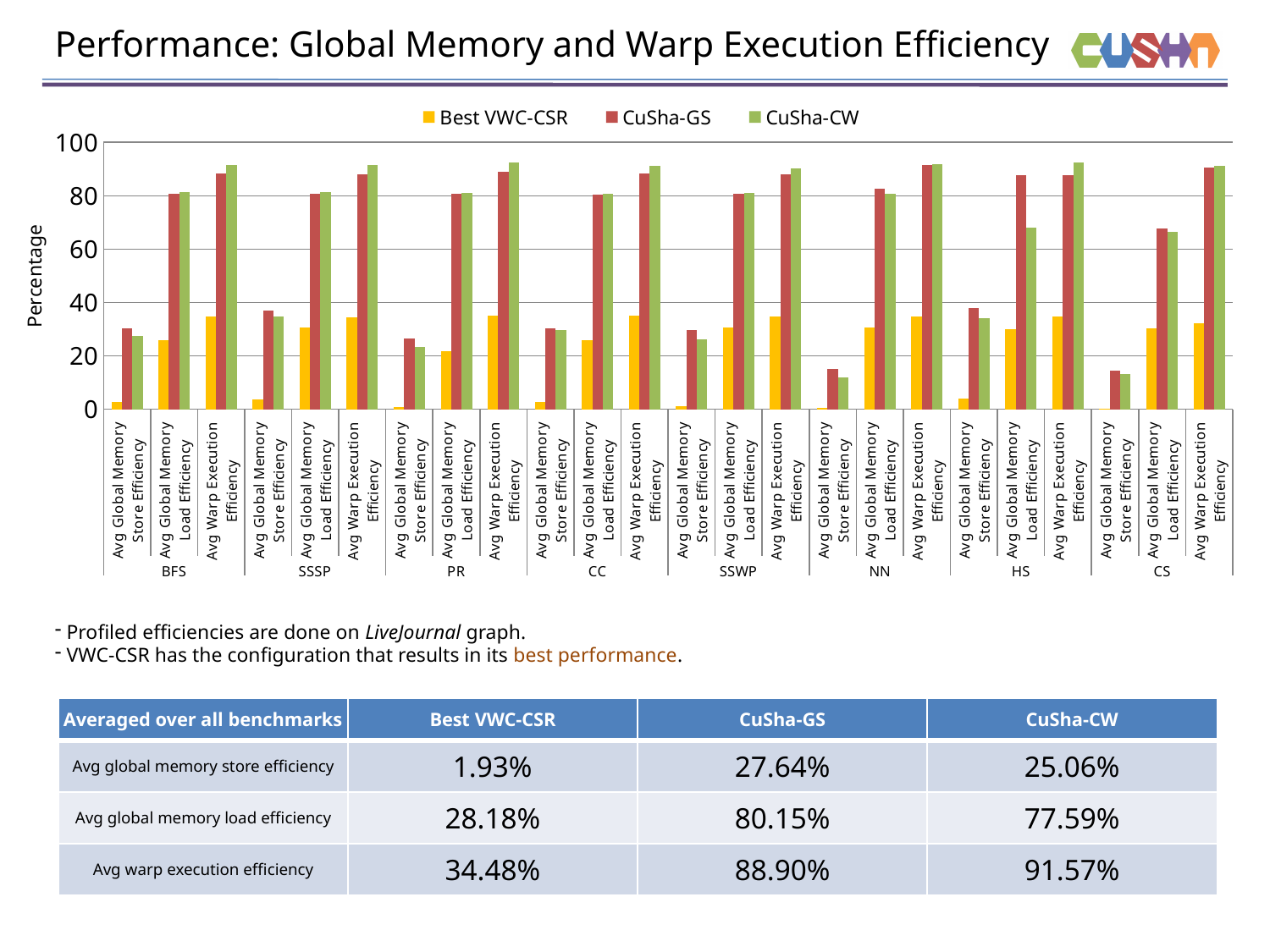
For Avg Warp Execution Efficiency under BFS, which is larger: Best VWC-CSR or CuSha-CW? CuSha-CW For Avg Global Memory Load Efficiency under HS, which is larger: CuSha-GS or CuSha-CW? CuSha-GS Which series is shown in yellow in the chart's legend? Best VWC-CSR How many benchmark groups (BFS, SSSP, etc.) are shown along the x axis of the chart? 8 What kind of chart is shown on the slide? bar chart Is the CuSha-GS value for Avg Global Memory Store Efficiency under NN greater or less than 20? less What is the title of the chart's vertical axis? Percentage Which series has the lowest value for Avg Global Memory Store Efficiency under SSWP? Best VWC-CSR Is the Best VWC-CSR value for Avg Global Memory Store Efficiency under BFS greater or less than 20? less How many series does the chart's legend list? 3 Is the CuSha-GS value for Avg Warp Execution Efficiency under PR greater or less than 80? greater